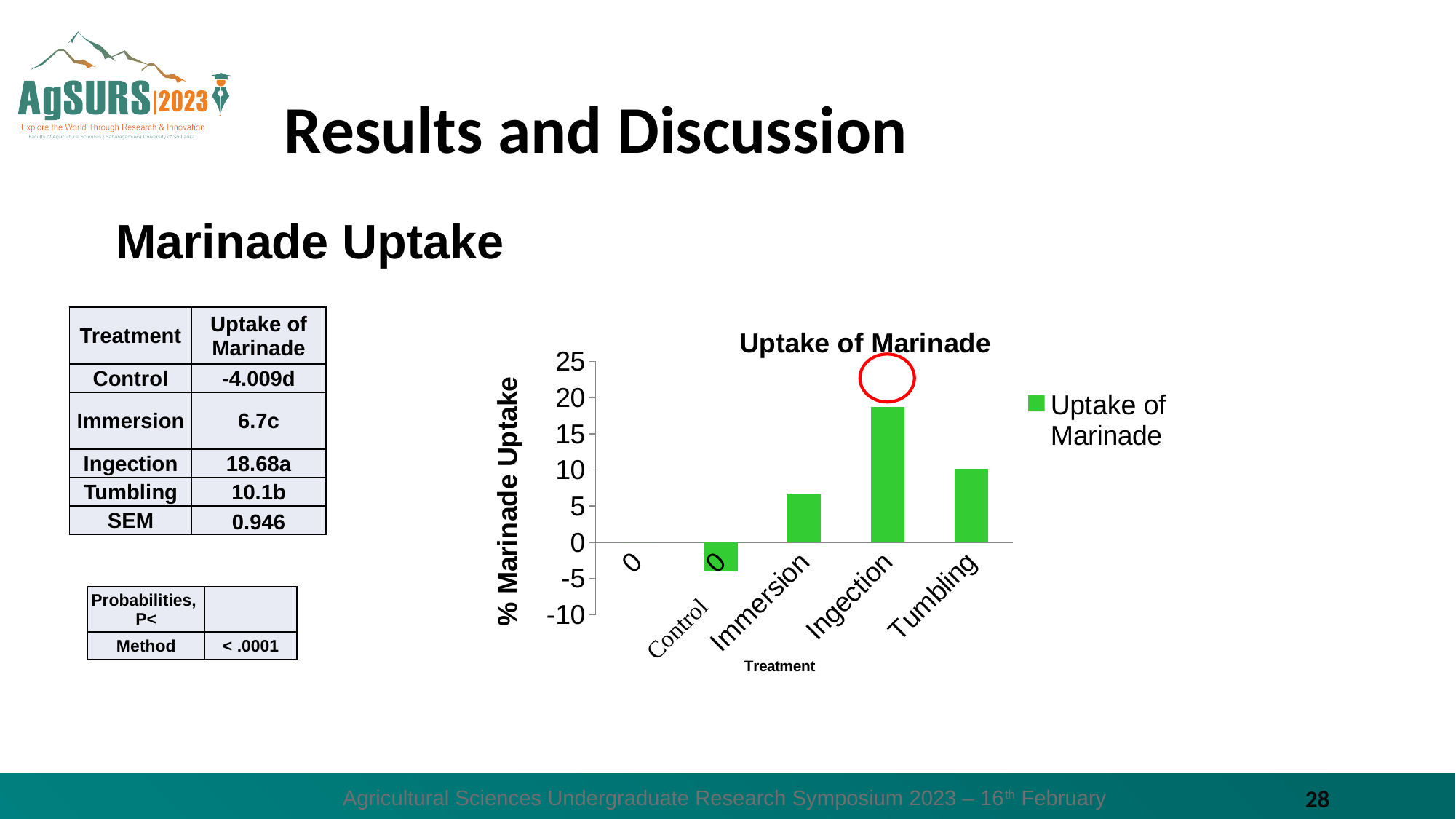
In the Uptake of Marinade chart, which treatment has the highest % marinade uptake? Ingection How many series does the legend of the Uptake of Marinade chart list? 1 In the Uptake of Marinade chart, is the value for Tumbling greater or less than 5? greater In the Uptake of Marinade chart, is the value for Ingection greater or less than 15? greater In the Uptake of Marinade chart, which is larger, the value for Ingection or the value for Tumbling? Ingection What is the title of the chart on the slide? Uptake of Marinade In the Uptake of Marinade chart, is the value for Immersion greater or less than 10? less What kind of chart is shown on the slide? bar chart What is the label on the vertical axis of the chart? % Marinade Uptake In the Uptake of Marinade chart, which treatment has the lowest % marinade uptake? Control In the Uptake of Marinade chart, which is larger, the value for Tumbling or the value for Immersion? Tumbling